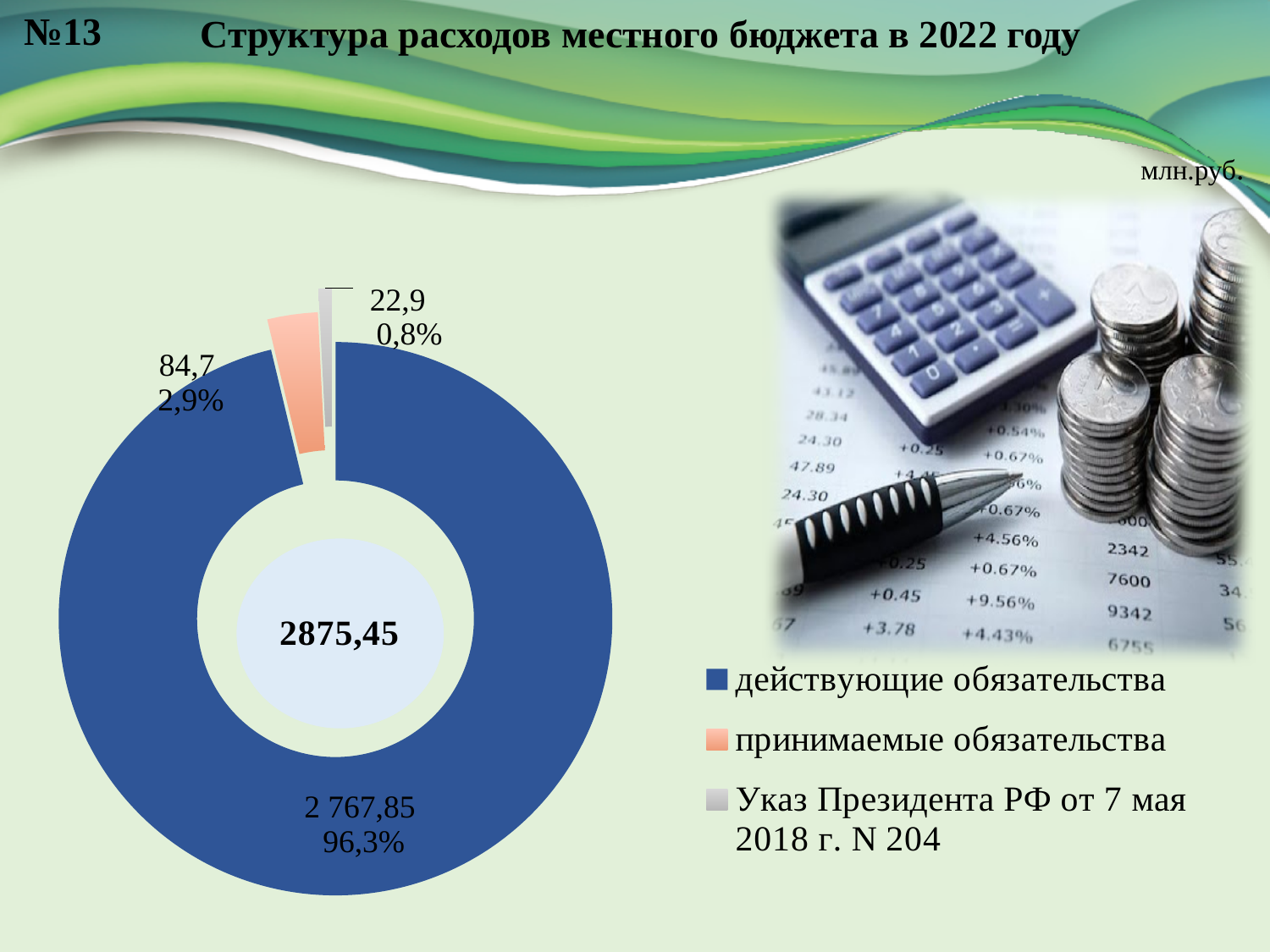
How many categories does the legend list? 3 What share of the chart does принимаемые обязательства represent? 2,9% What is the value for принимаемые обязательства? 84,7 What is the value for Указ Президента РФ от 7 мая 2018 г. N 204? 22,9 What share of the chart does действующие обязательства represent? 96,3% What is the value for действующие обязательства? 2 767,85 Which category has the largest value? действующие обязательства What kind of chart is shown on the slide? Doughnut (pie) chart What share of the chart does Указ Президента РФ от 7 мая 2018 г. N 204 represent? 0,8% Which category has the smallest value? Указ Президента РФ от 7 мая 2018 г. N 204 What is the difference between the values for принимаемые обязательства and Указ Президента РФ от 7 мая 2018 г. N 204? 61,8 What total value is shown in the centre of the chart? 2875,45